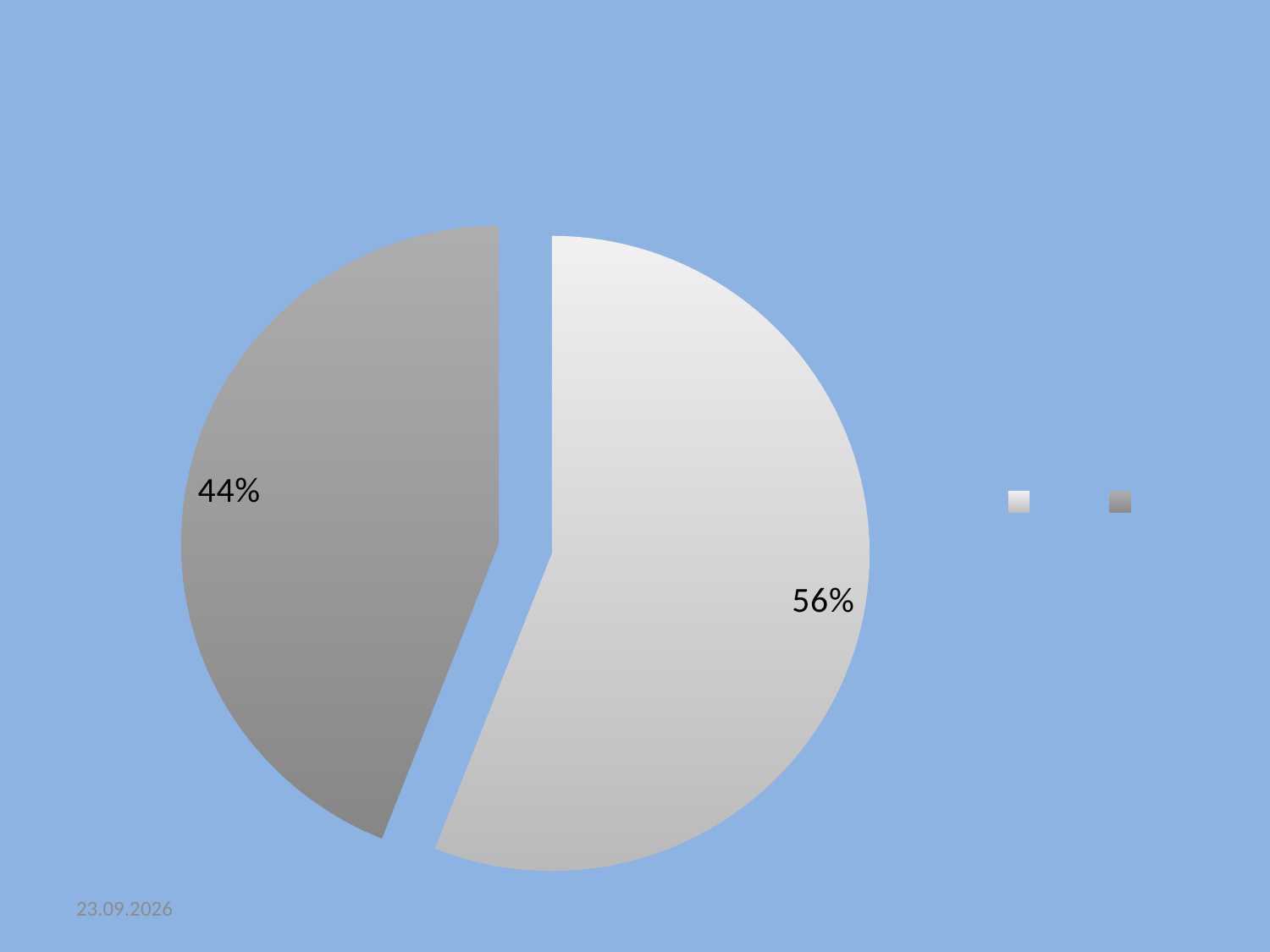
What kind of chart is shown on the slide? pie chart What do the two slice percentages add up to? 100% Which is larger, the light grey slice or the dark grey slice? the light grey slice Which slice of the pie chart is the smallest? the dark grey slice (44%) Which slice of the pie chart is the largest? the light grey slice (56%) Is the light grey slice's share greater or less than 50%? greater What percentage is shown on the light grey slice of the pie chart? 56% How many slices does the pie chart have? 2 What percentage is shown on the dark grey slice of the pie chart? 44% By how many percentage points does the light grey slice exceed the dark grey slice? 12 percentage points How many entries does the legend show? 2